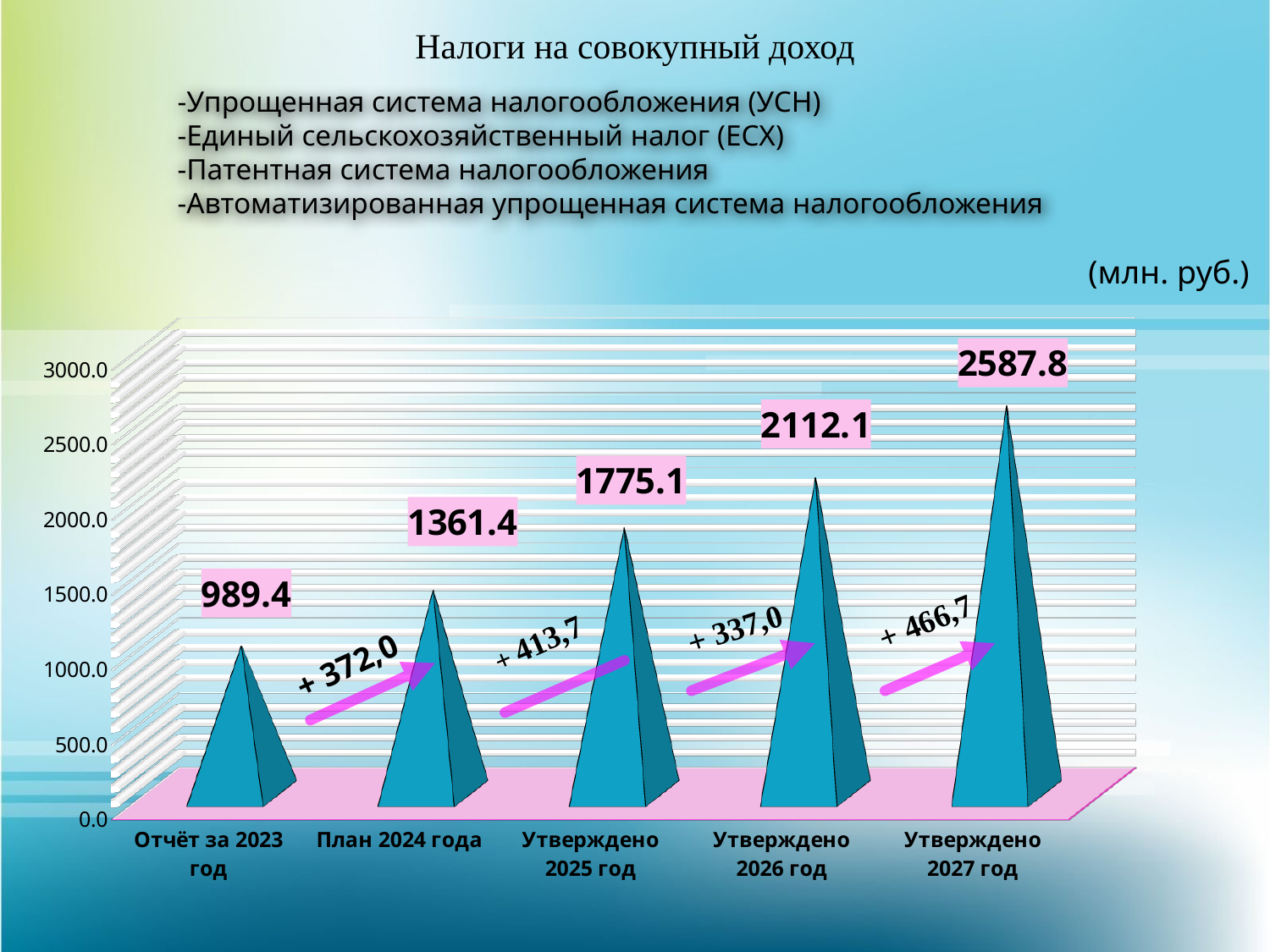
What is the value for «Утверждено 2027 год»? 2587.8 Which category has the highest value? Утверждено 2027 год Is the value for «Утверждено 2026 год» greater or less than 2000.0? greater What is the difference between the values for «Утверждено 2026 год» and «Утверждено 2025 год»? 337.0 How many categories are shown on the x axis? 5 What is the value for «План 2024 года»? 1361.4 Do the values rise or fall from left to right along the x axis? rise What is the value for «Отчёт за 2023 год»? 989.4 Which is larger, the value for «План 2024 года» or the value for «Утверждено 2025 год»? Утверждено 2025 год Which category has the lowest value? Отчёт за 2023 год What is the value for «Утверждено 2025 год»? 1775.1 What kind of chart is shown on the slide? bar chart